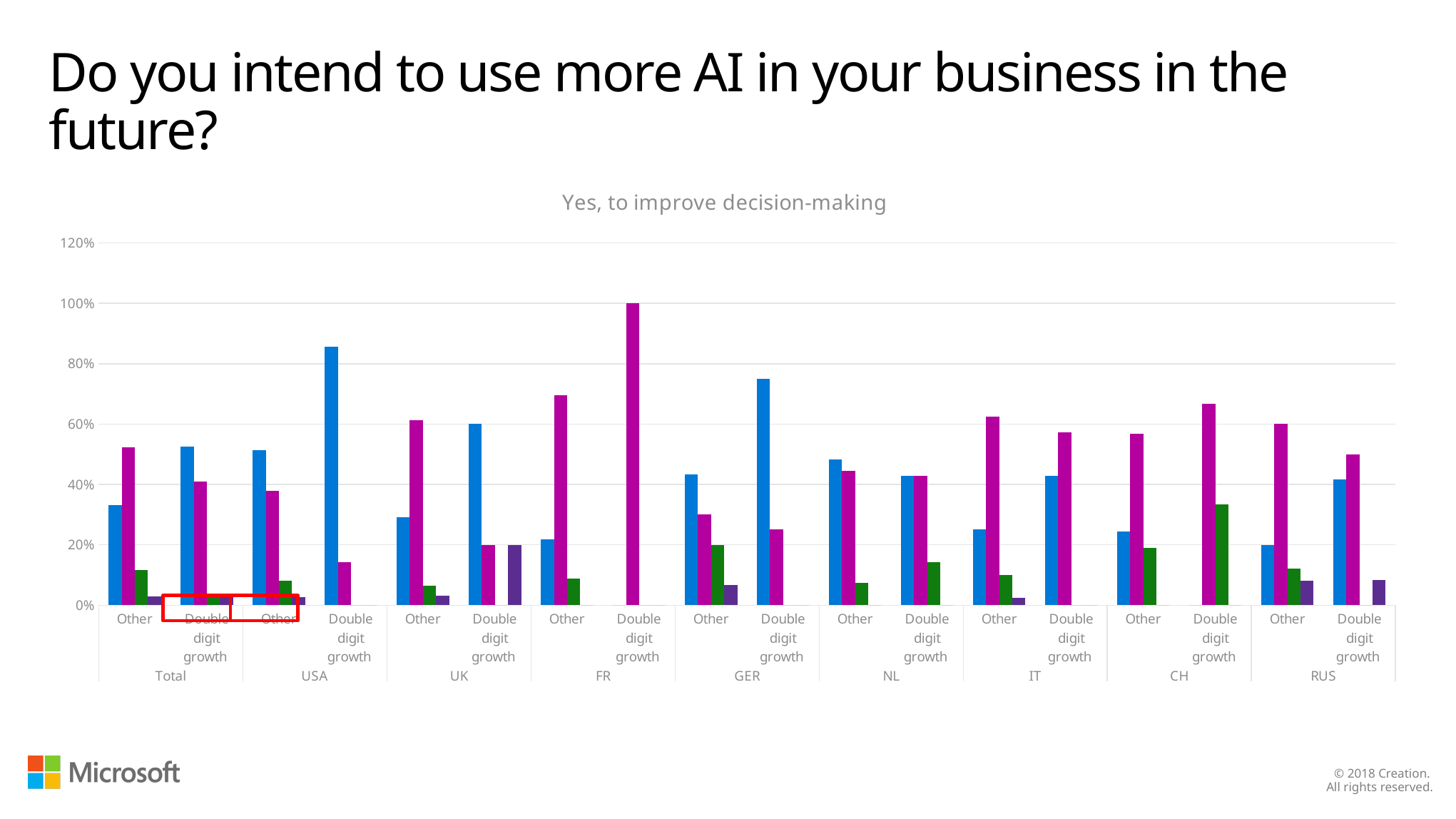
Is the blue bar for Double digit growth in GER greater or less than 60%? greater Is the green bar for Double digit growth in CH greater or less than 40%? less Is the magenta bar for Double digit growth in CH greater or less than 60%? greater What is the title of the chart? Yes, to improve decision-making In the USA group, which is larger for Double digit growth: the blue bar or the magenta bar? the blue bar What kind of chart is shown on the slide? bar chart What value does the magenta bar for Double digit growth in FR reach? 100% In the IT group, which is larger for Other: the blue bar or the magenta bar? the magenta bar How many country/region groups are shown along the x axis of the chart? 9 Which group and category has the tallest bar in the chart? FR, Double digit growth